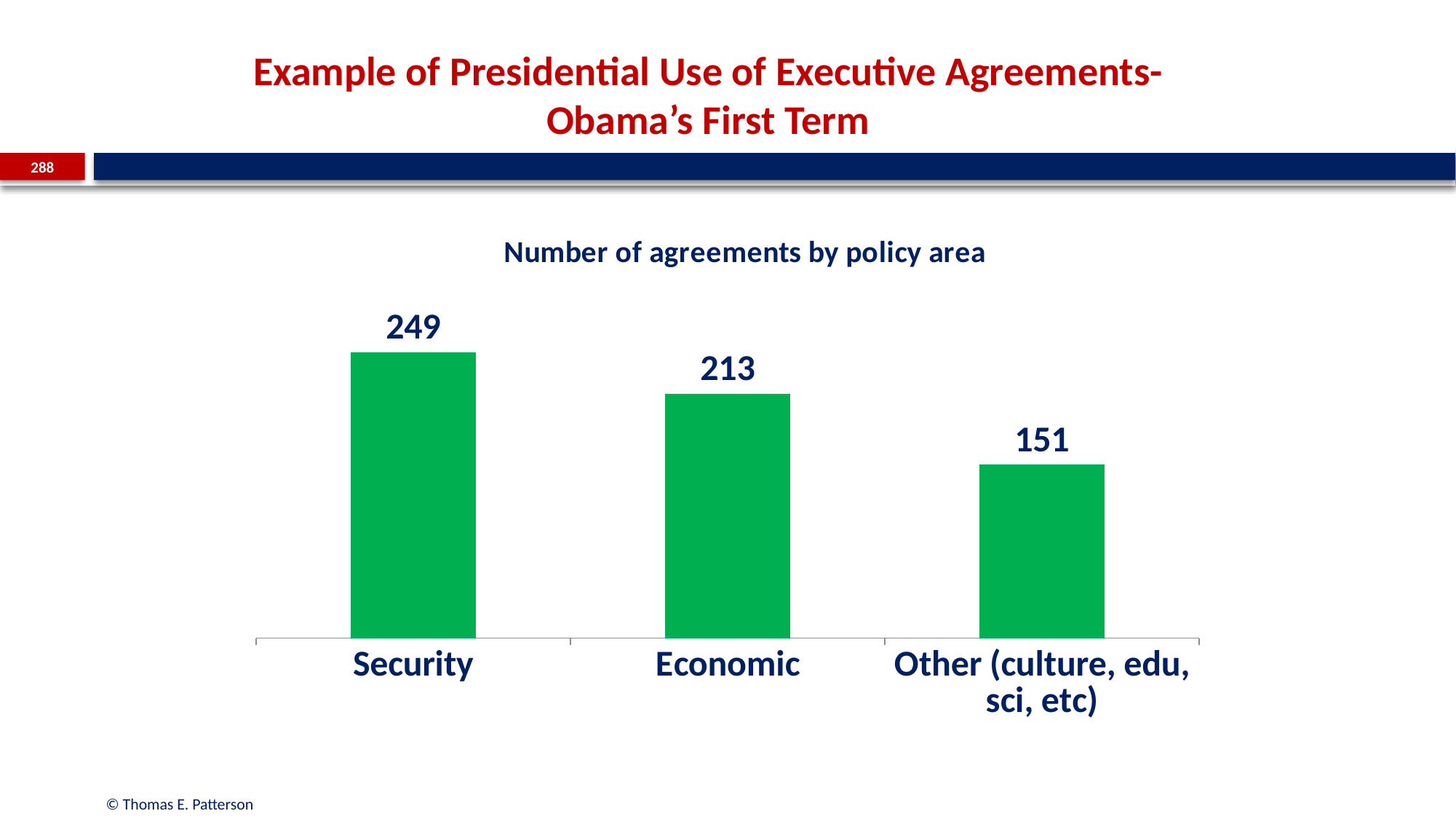
Do the values rise or fall from left to right across the categories? Fall Which policy area has the lowest number of agreements? Other (culture, edu, sci, etc) Which policy area has the highest number of agreements? Security How many policy areas are shown in the chart? 3 What is the title of the chart? Number of agreements by policy area What is the number of agreements for Other (culture, edu, sci, etc)? 151 Which has more agreements, Economic or Other (culture, edu, sci, etc)? Economic What is the number of agreements for Security? 249 What is the difference between the number of agreements for Economic and Other (culture, edu, sci, etc)? 62 What kind of chart is shown on the slide? Bar chart What is the number of agreements for Economic? 213 What is the difference between the number of agreements for Security and Economic? 36